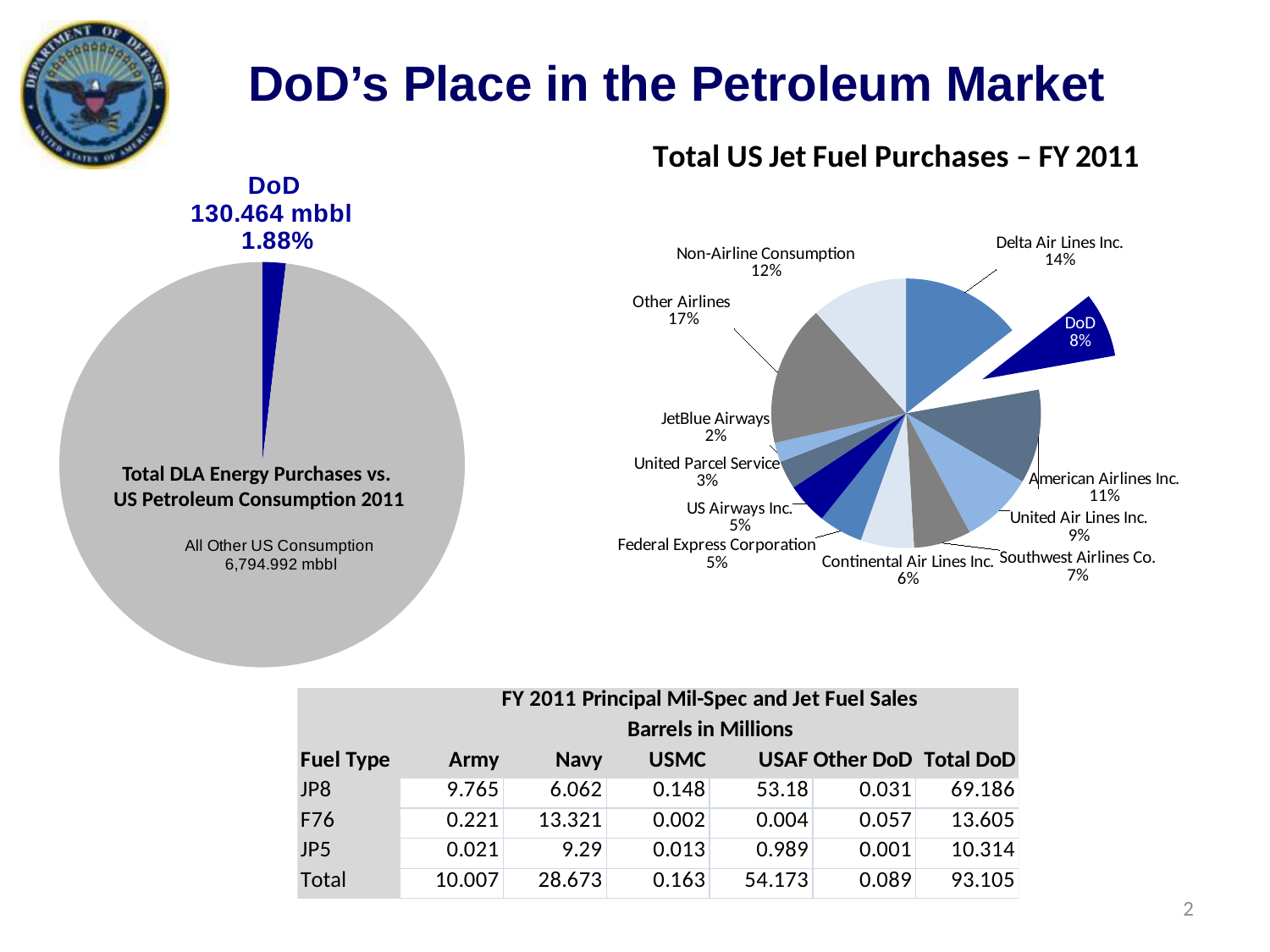
In the Total DLA Energy Purchases vs. US Petroleum Consumption 2011 pie chart, what value is shown for All Other US Consumption? 6,794.992 mbbl In the Total US Jet Fuel Purchases – FY 2011 pie chart, what is the difference in percentage points between American Airlines Inc. and United Air Lines Inc.? 2 In the Total DLA Energy Purchases vs. US Petroleum Consumption 2011 pie chart, what value is shown for DoD? 130.464 mbbl In the Total US Jet Fuel Purchases – FY 2011 pie chart, which labelled slice has the smallest share? JetBlue Airways In the Total US Jet Fuel Purchases – FY 2011 pie chart, what share is shown for DoD? 8% In the Total US Jet Fuel Purchases – FY 2011 pie chart, which has the larger share, Southwest Airlines Co. or Continental Air Lines Inc.? Southwest Airlines Co. In the Total US Jet Fuel Purchases – FY 2011 pie chart, what share is shown for Non-Airline Consumption? 12% In the Total US Jet Fuel Purchases – FY 2011 pie chart, what share is shown for Delta Air Lines Inc.? 14% In the Total DLA Energy Purchases vs. US Petroleum Consumption 2011 pie chart, what percentage share does DoD have? 1.88% What kind of chart is used for Total US Jet Fuel Purchases – FY 2011? Pie chart How many slices are labelled in the Total US Jet Fuel Purchases – FY 2011 pie chart? 12 In the Total US Jet Fuel Purchases – FY 2011 pie chart, which labelled slice has the largest share? Other Airlines